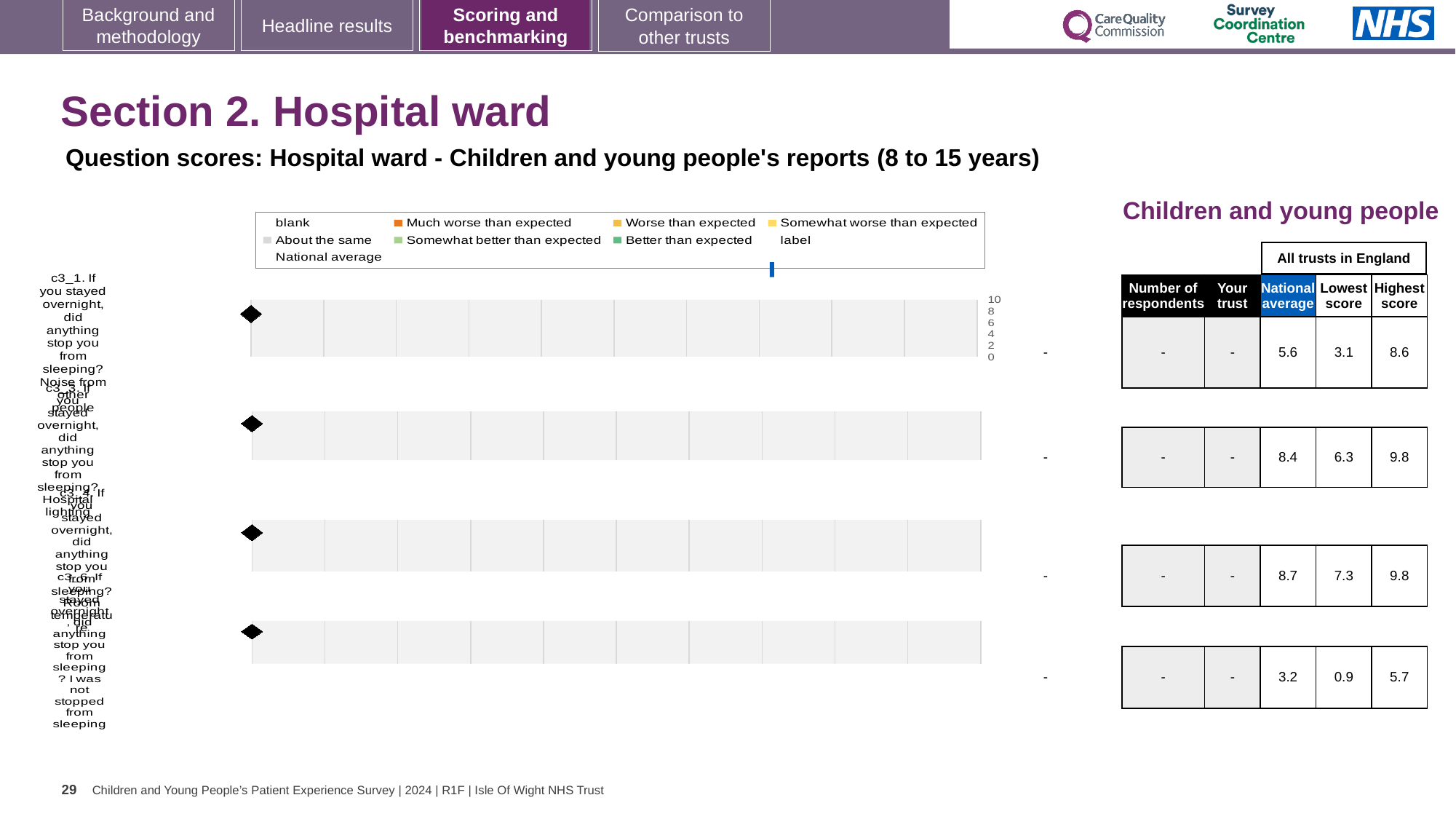
In the table beside the chart, what is the Highest score for the fourth row (c3_6, I was not stopped from sleeping)? 5.7 What kind of chart is shown on the slide? bar chart In the table beside the chart, what is the National average for the first row (c3_1, noise from other people)? 5.6 How many entries does the chart's legend list? 9 What is the highest tick value shown on the chart's axis? 10 In the table beside the chart, what is the difference between the Highest score and Lowest score for the first row (c3_1)? 5.5 In the table beside the chart, what is the Lowest score for the first row (c3_1)? 3.1 How many question categories (rows) does the chart show? 4 In the table beside the chart, is the National average for the second row (c3_3, hospital lighting) larger or smaller than that for the third row (c3_4)? smaller What colour does the legend use for 'Much worse than expected'? orange In the table beside the chart, which row has the highest National average? third row (c3_4, room temperature), 8.7 In the table beside the chart, which row has the lowest National average? fourth row (c3_6), 3.2